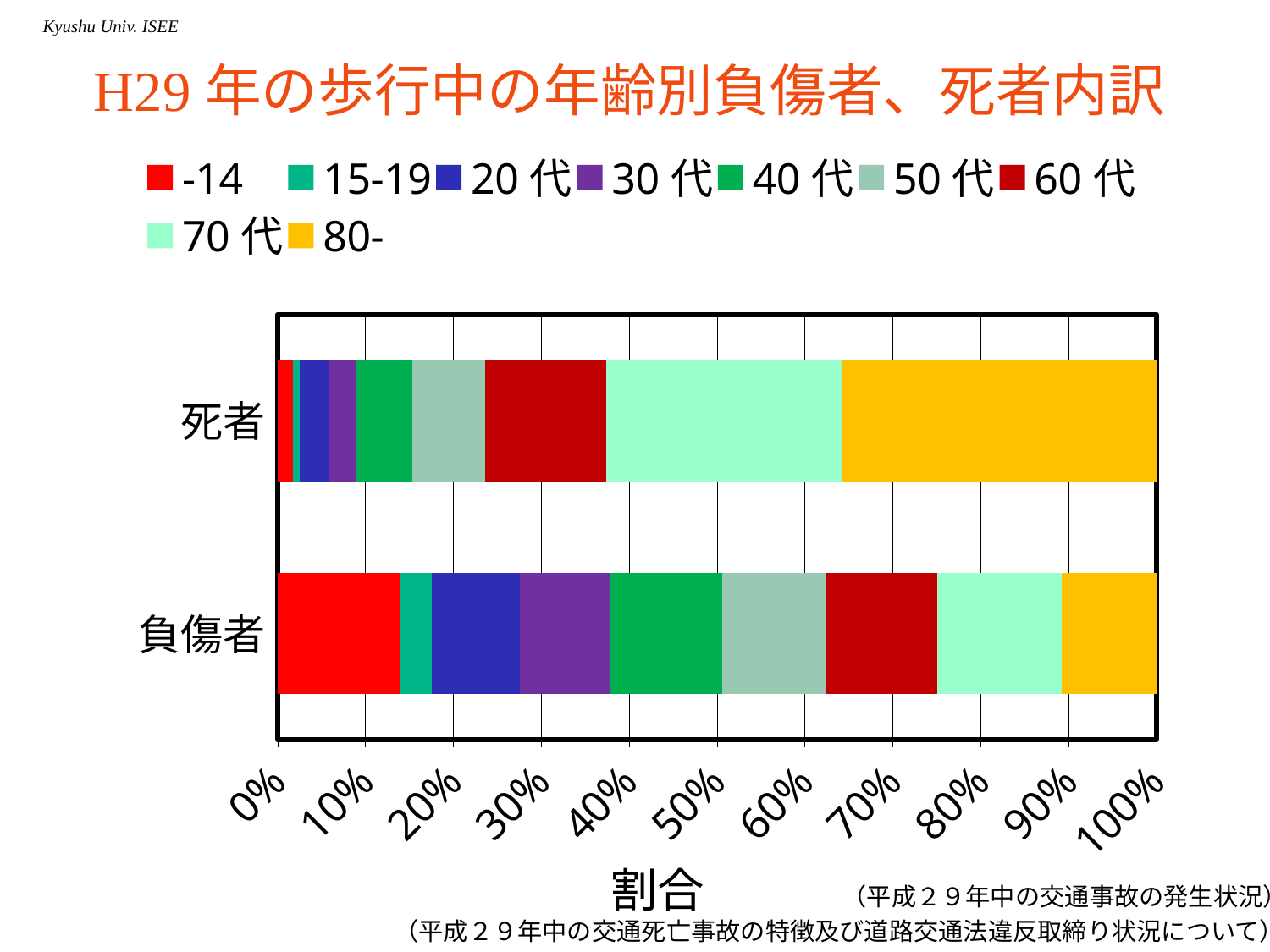
Is the share of the 80- group in the 死者 bar greater or less than 30%? greater Which age group has the smallest segment in the 死者 bar? 15-19 What is the label of the horizontal axis? 割合 Is the share of the 80- group larger in the 死者 bar or the 負傷者 bar? 死者 How many categories (bars) does the chart show? 2 How many series does the legend list? 9 What kind of chart is shown on the slide? Stacked bar chart Which age group has the largest segment in the 死者 bar? 80- Is the share of the -14 group in the 負傷者 bar greater or less than 10%? greater Is the share of the -14 group larger in the 死者 bar or the 負傷者 bar? 負傷者 Which age group has the smallest segment in the 負傷者 bar? 15-19 What is the title of the chart on the slide? H29年の歩行中の年齢別負傷者、死者内訳